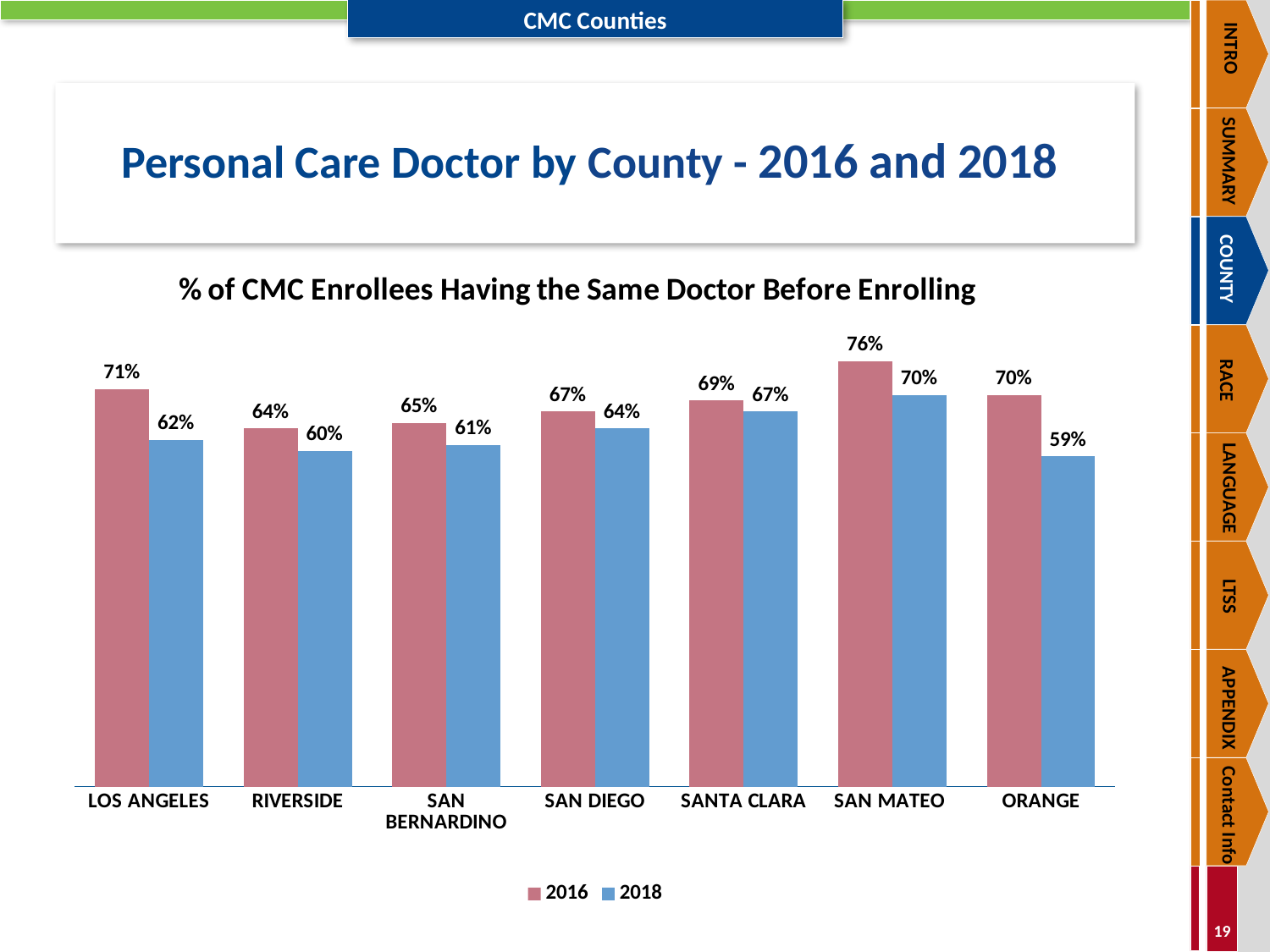
What is the 2018 value for San Bernardino? 61% What kind of chart is shown? Bar chart Which county has the lowest 2018 value? Orange How many series does the legend list? 2 How many counties are shown on the x axis? 7 What is the difference between the 2016 values for San Mateo and Riverside? 12% What is the chart's title? % of CMC Enrollees Having the Same Doctor Before Enrolling What is the 2018 value for Orange? 59% What is the 2016 value for San Mateo? 76% Which is larger, the 2018 value for Santa Clara or the 2018 value for Los Angeles? Santa Clara Which county has the highest 2016 value? San Mateo What is the difference between the 2016 and 2018 values for Orange? 11%